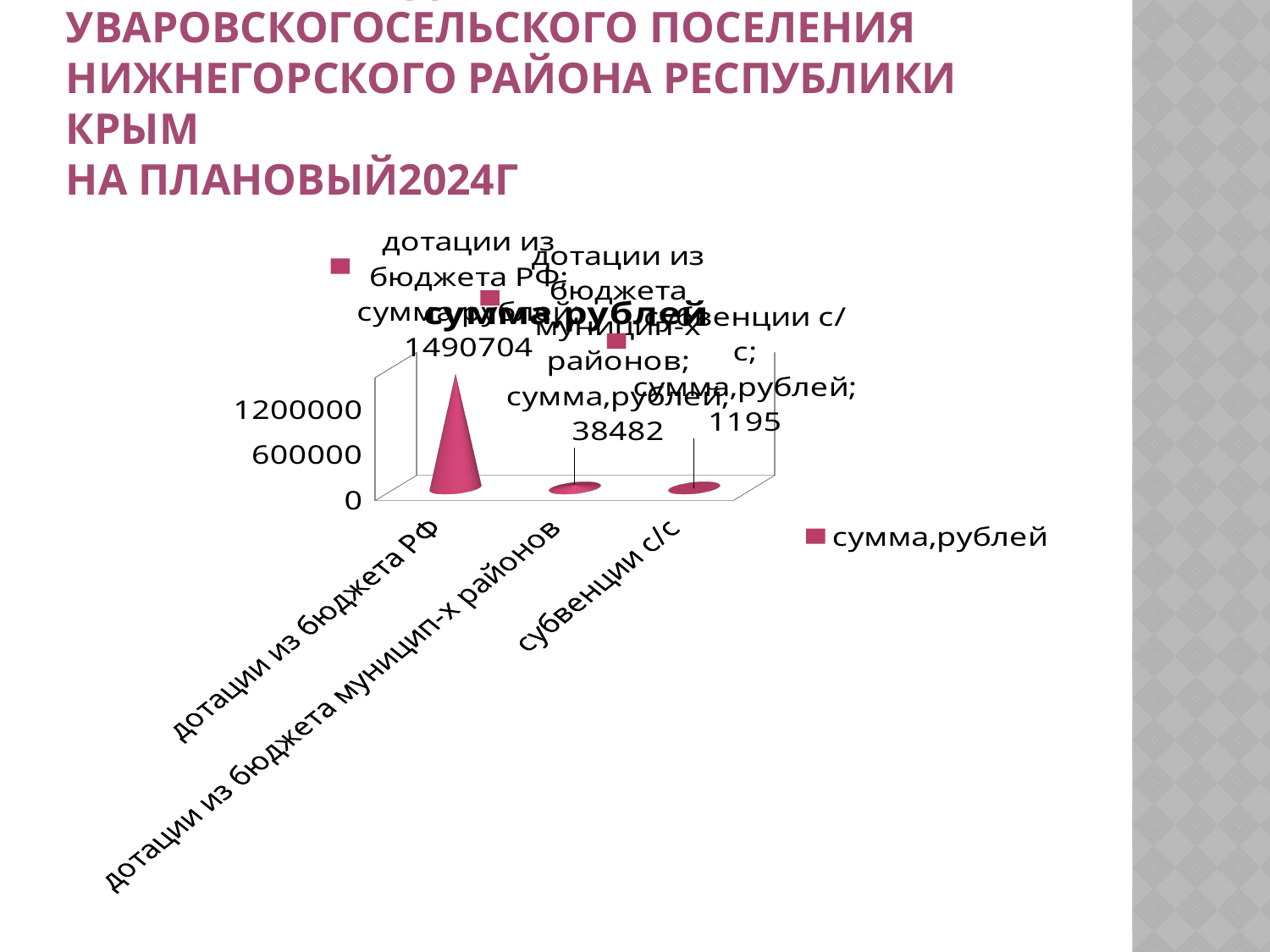
What is the value for дотации из бюджета муницип-х районов? 38482 Is the value for дотации из бюджета РФ greater or less than 1200000? greater What is the value for субвенции с/с? 1195 What is the difference between the values for дотации из бюджета РФ and дотации из бюджета муницип-х районов? 1452222 What is the name of the series shown in the legend? сумма,рублей Which category has the lowest value? субвенции с/с Which is larger: the value for дотации из бюджета муницип-х районов or the value for субвенции с/с? дотации из бюджета муницип-х районов How many series does the legend list? 1 How many categories are shown on the x axis? 3 What is the value for дотации из бюджета РФ? 1490704 Which category has the highest value? дотации из бюджета РФ What is the difference between the values for дотации из бюджета муницип-х районов and субвенции с/с? 37287